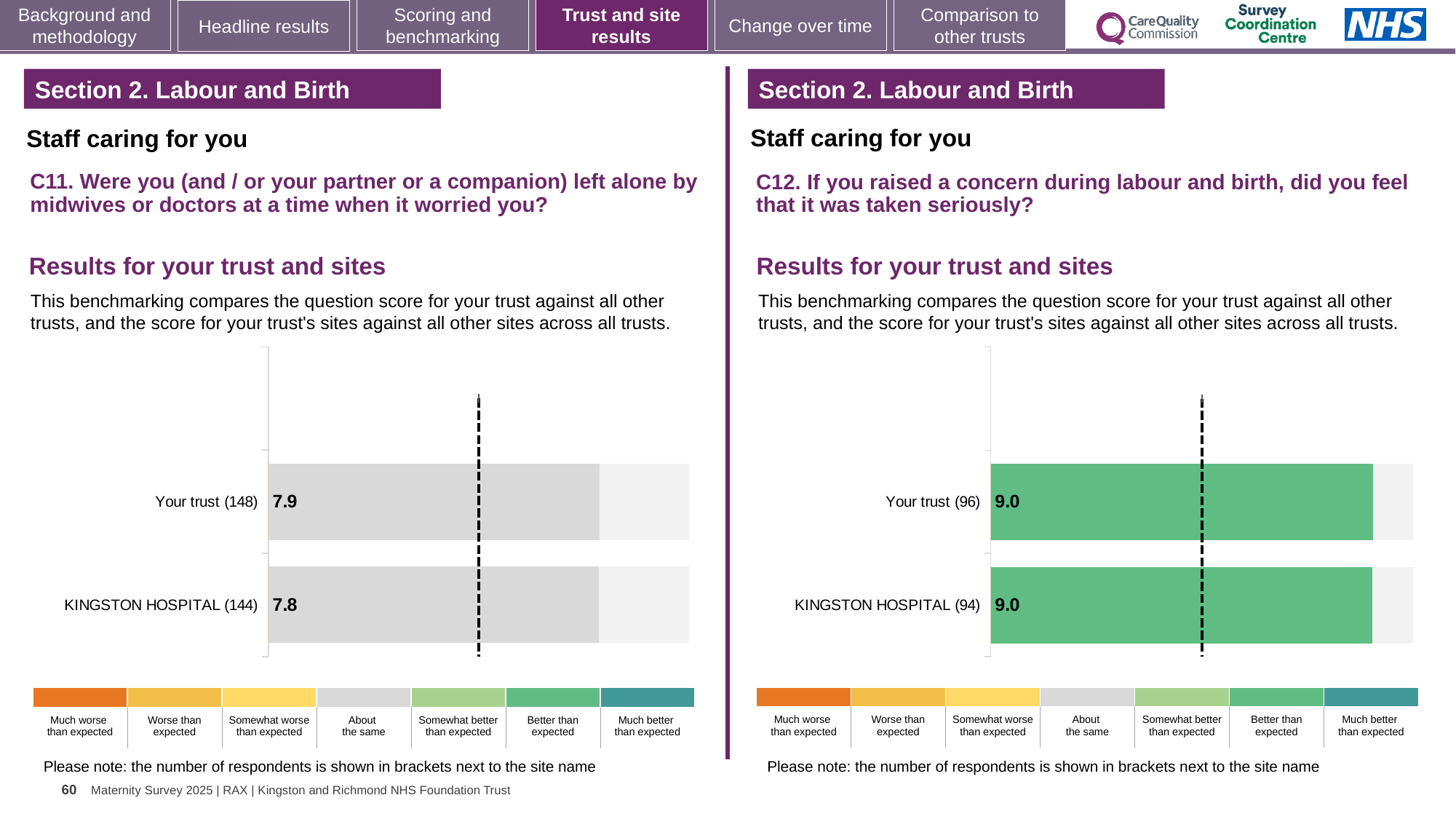
In the C11 chart on the left, which benchmark category does the colour of the bars correspond to? About the same In the C11 chart on the left, what is the score for Your trust? 7.9 In the C11 chart on the left, what is the score for KINGSTON HOSPITAL? 7.8 In the C11 chart on the left, what is the difference between the Your trust score and the KINGSTON HOSPITAL score? 0.1 In the C11 chart on the left, how many respondents are shown in brackets for Your trust? 148 In the C11 chart on the left, which has the higher score, Your trust or KINGSTON HOSPITAL? Your trust In the C12 chart on the right, what is the score for Your trust? 9.0 What kind of chart is used in the C11 chart on the left? Bar chart In the C12 chart on the right, which benchmark category does the colour of the bars correspond to? Better than expected In the C12 chart on the right, what is the score for KINGSTON HOSPITAL? 9.0 In the C12 chart on the right, how many respondents are shown in brackets for KINGSTON HOSPITAL? 94 How many bars are plotted in the C12 chart on the right? 2